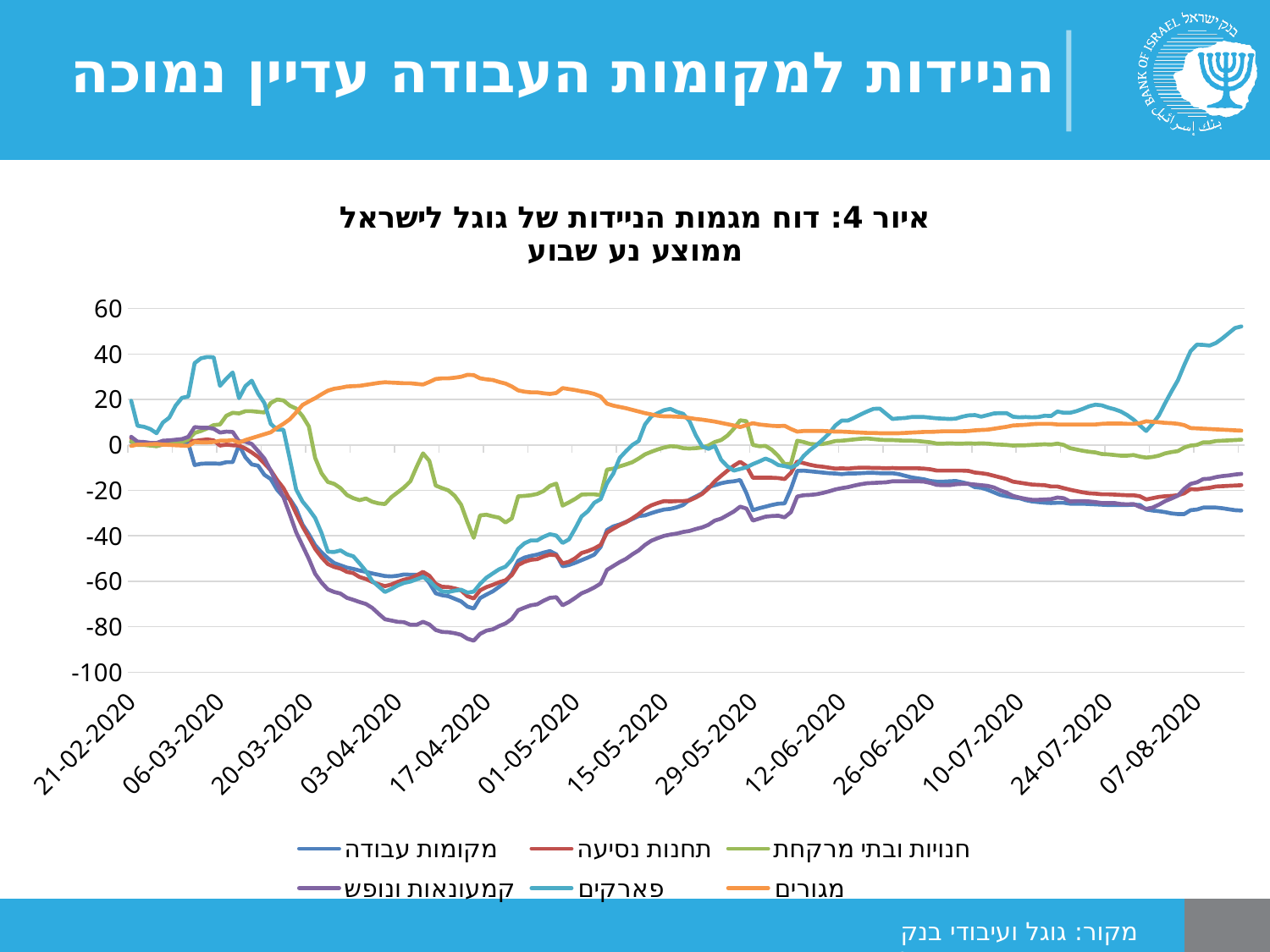
Does the מגורים line rise or fall between 21-02-2020 and 17-04-2020? rise Is the value for חנויות ובתי מרקחת at 17-04-2020 greater or less than -20? less What colour is the line for מגורים? orange Is the value for מקומות עבודה at 07-08-2020 greater or less than -20? less How many date labels are shown along the x axis? 13 How many series does the legend list? 6 Is the value for פארקים at 07-08-2020 greater or less than 20? greater What kind of chart is shown on the slide? line chart Does the פארקים line rise or fall between 24-07-2020 and the end of the series? rise What is the title of the chart? איור 4: דוח מגמות הניידות של גוגל לישראל ממוצע נע שבוע